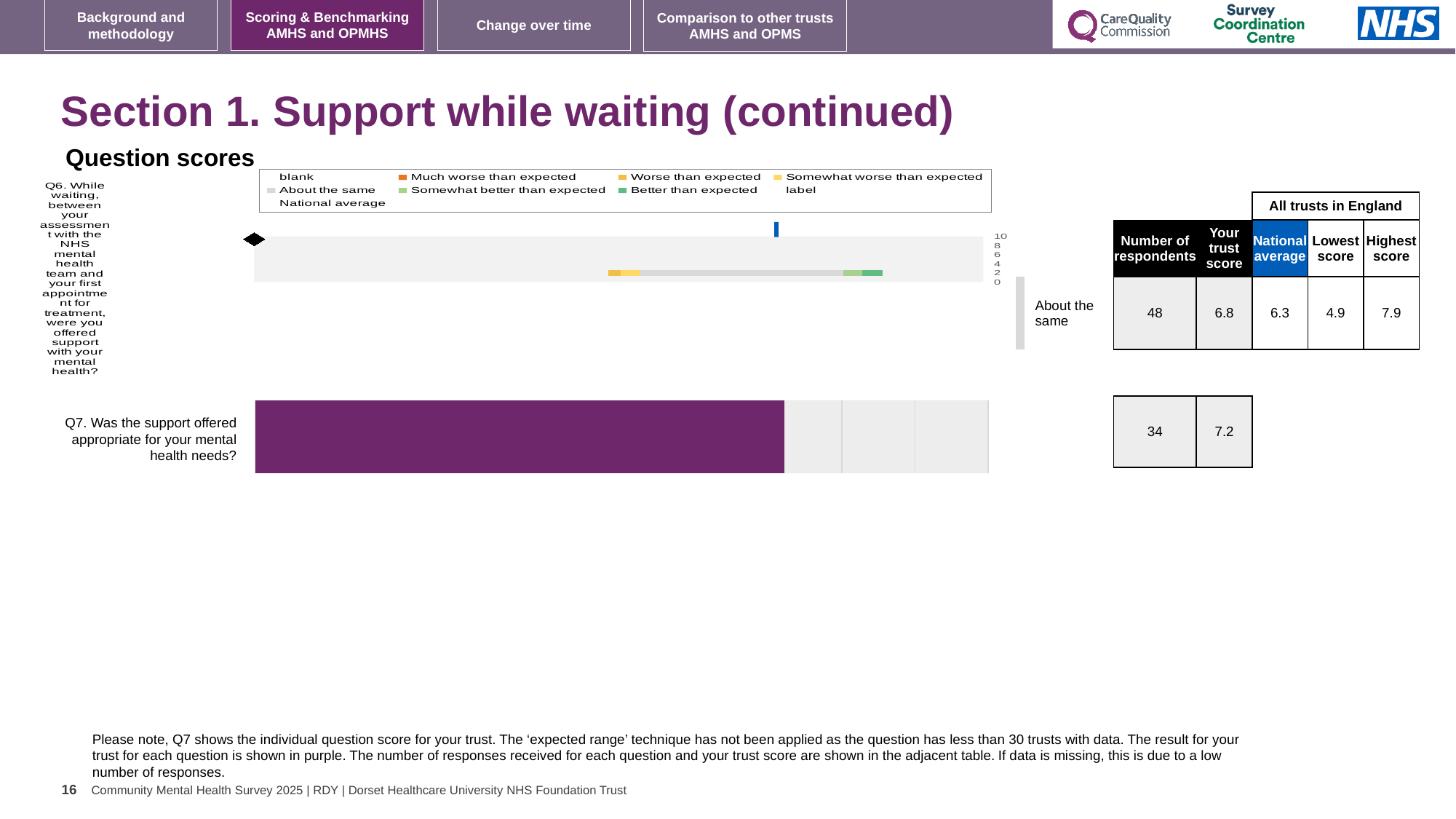
Is the trust score for Q6 larger or smaller than the national average for Q6? larger What category label is shown beside the Q6 chart to describe the trust's result? About the same How many respondents answered Q7? 34 What is the national average for Q6 shown in the table next to the chart? 6.3 What kind of chart is used to show the Q7 score on the slide? bar chart What is the lowest score among all trusts in England for Q6? 4.9 Is the Q7 purple bar greater or less than 6 on the 0 to 10 axis? greater How many respondents answered Q6? 48 What is the trust score for Q6 shown in the table next to the chart? 6.8 What is the trust score for Q7 shown next to the purple bar? 7.2 What is the highest score among all trusts in England for Q6? 7.9 What is the difference between the highest and lowest scores for Q6 across all trusts in England? 3.0